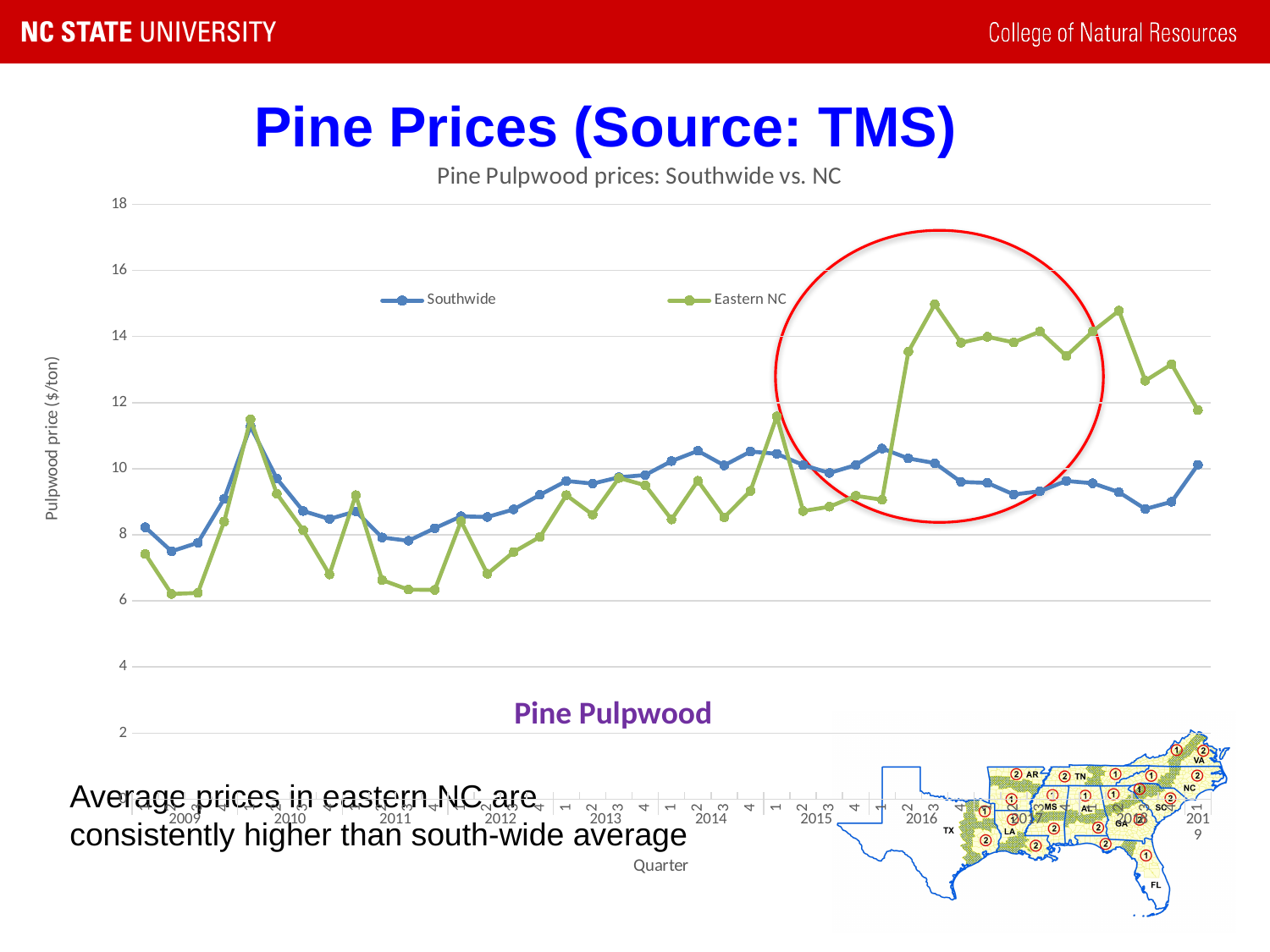
How many series does the legend list? 2 Which series has the lowest point on the chart? Eastern NC What kind of chart is shown on the slide? line chart What are the two series named in the legend? Southwide and Eastern NC In quarter 2 of 2011, which series has the higher value, Southwide or Eastern NC? Southwide Is the lowest value of the Eastern NC series in 2009 greater or less than 8? less Which series reaches the highest value on the chart? Eastern NC In quarter 3 of 2016, which series has the higher value, Southwide or Eastern NC? Eastern NC Is the peak value of the Eastern NC series in 2016 greater or less than 14? greater Is the highest value of the Southwide series greater or less than 12? less Does the Eastern NC series rise or fall overall from quarter 3 of 2016 to quarter 1 of 2019? fall What is the title printed above the chart? Pine Pulpwood prices: Southwide vs. NC